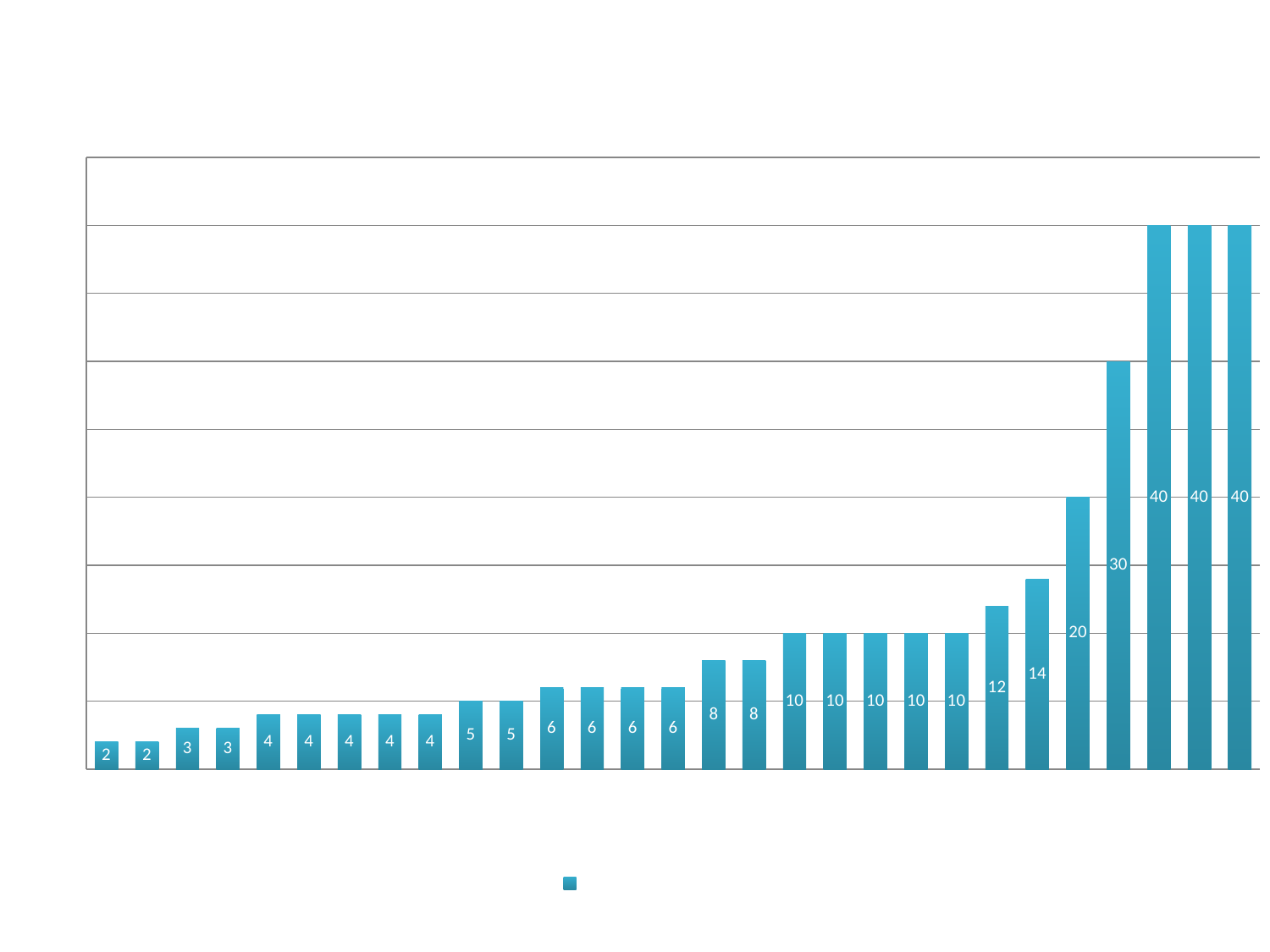
What is the difference between the rightmost bar's value and the leftmost bar's value? 38 What is the lowest value shown by a data label in the chart? 2 How many bars in the chart have a value of 40? 3 What is the value of the rightmost bar in the chart? 40 What kind of chart is shown on the slide? bar chart How many series does the legend show? 1 Do the bar values rise or fall from left to right across the chart? rise What is the highest value shown by a data label in the chart? 40 Which is larger, the value of the bar labelled 30 or the bar labelled 20? 30 What is the value of the leftmost bar in the chart? 2 How many bars are plotted in the chart? 29 How many bars in the chart have a value of 10? 5